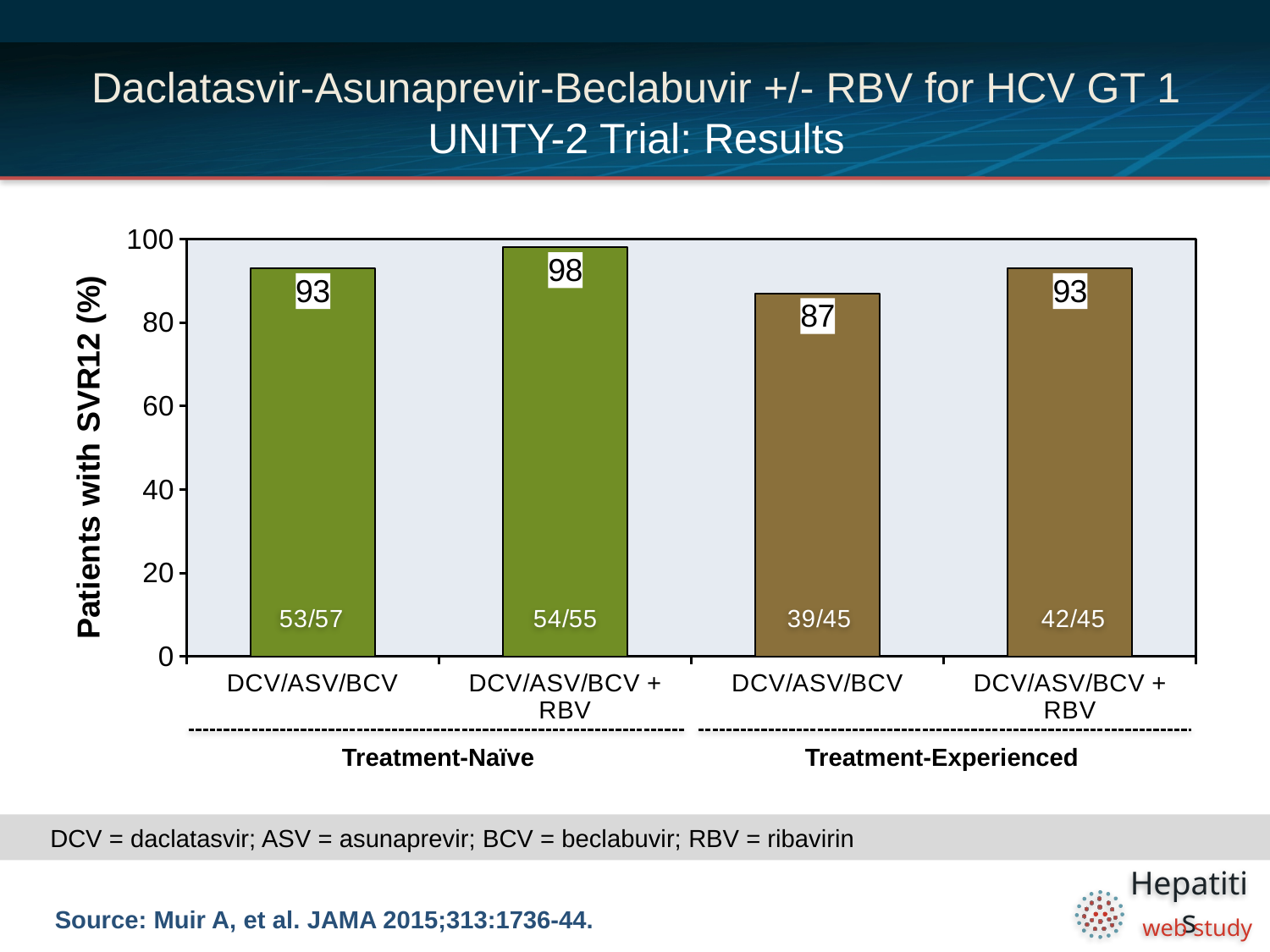
Is the SVR12 rate for the treatment-experienced DCV/ASV/BCV group greater or less than 80? greater What type of chart is shown on the slide? Bar chart What is the SVR12 rate for the DCV/ASV/BCV + RBV group among treatment-naïve patients? 98 What is the SVR12 rate for the DCV/ASV/BCV group among treatment-experienced patients? 87 What is the label of the y-axis? Patients with SVR12 (%) How many patients achieved SVR12 out of the total in the treatment-experienced DCV/ASV/BCV + RBV group? 42/45 Which group has the lowest SVR12 rate? Treatment-Experienced DCV/ASV/BCV How many bars are shown in the chart? 4 What is the SVR12 rate for the DCV/ASV/BCV group among treatment-naïve patients? 93 Which group has the highest SVR12 rate? Treatment-Naïve DCV/ASV/BCV + RBV Which has a higher SVR12 rate: treatment-naïve DCV/ASV/BCV or treatment-experienced DCV/ASV/BCV? Treatment-naïve DCV/ASV/BCV What is the difference in SVR12 rate between the treatment-naïve DCV/ASV/BCV + RBV group and the treatment-experienced DCV/ASV/BCV group? 11